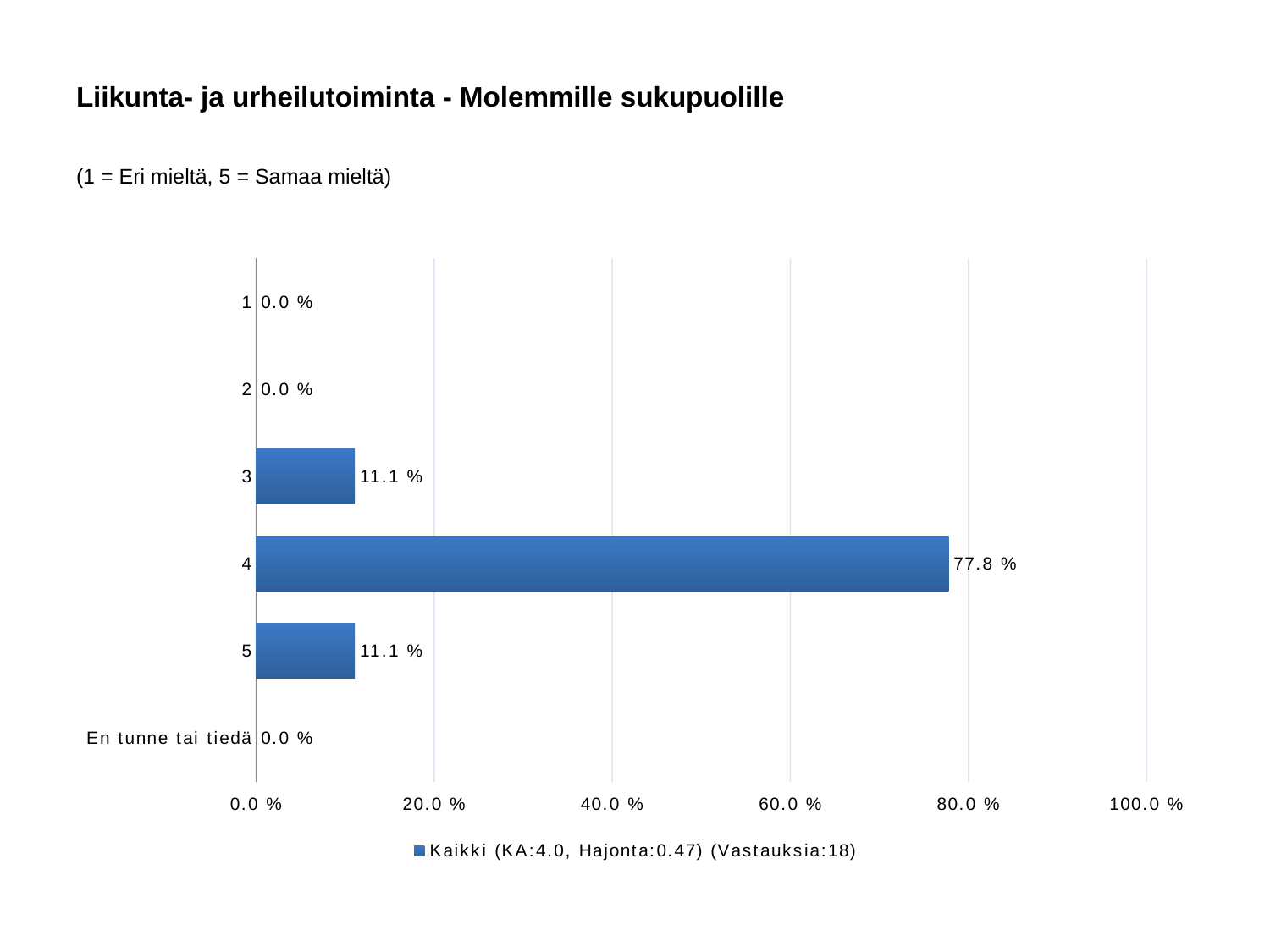
Which category has the highest value? 4 What is the value for category 3? 11.1 % What kind of chart is shown on the slide? bar chart What is the difference between the values for category 4 and category 5? 66.7 % What is the value for 'En tunne tai tiedä'? 0.0 % Which is larger, the value for category 4 or the value for category 3? 4 What is the title of the chart? Liikunta- ja urheilutoiminta - Molemmille sukupuolille Is the value for category 4 greater or less than 60.0 %? greater How many responses (Vastauksia) does the legend entry report? 18 How many series does the legend list? 1 What is the value for category 4? 77.8 % How many categories are shown on the chart? 6